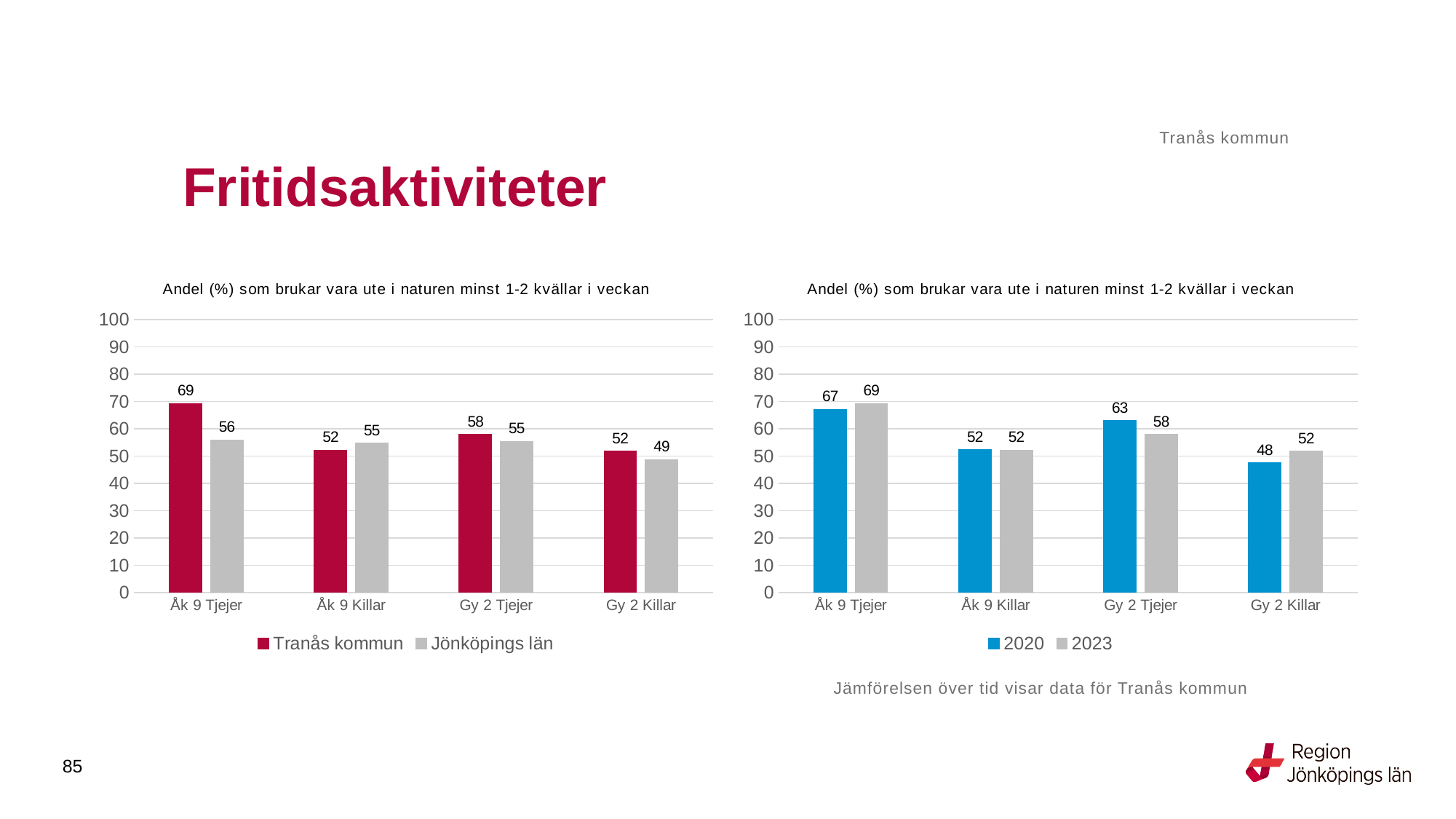
In the left chart, what is the value for Jönköpings län for Gy 2 Killar? 49 In the left chart, which is larger for Gy 2 Killar: Tranås kommun or Jönköpings län? Tranås kommun What kind of chart is the right chart? Bar chart In the right chart, what is the value for 2020 for Gy 2 Tjejer? 63 How many series does the legend of the left chart list? 2 In the right chart, what is the value for 2023 for Gy 2 Killar? 52 In the left chart, what is the value for Tranås kommun for Åk 9 Tjejer? 69 In the left chart, which category has the highest value for Tranås kommun? Åk 9 Tjejer In the right chart, which category has the lowest value for 2020? Gy 2 Killar How many categories are shown on the x axis of the right chart? 4 In the right chart, what is the difference between 2020 and 2023 for Gy 2 Tjejer? 5 In the left chart, what is the difference between Tranås kommun and Jönköpings län for Åk 9 Tjejer? 13